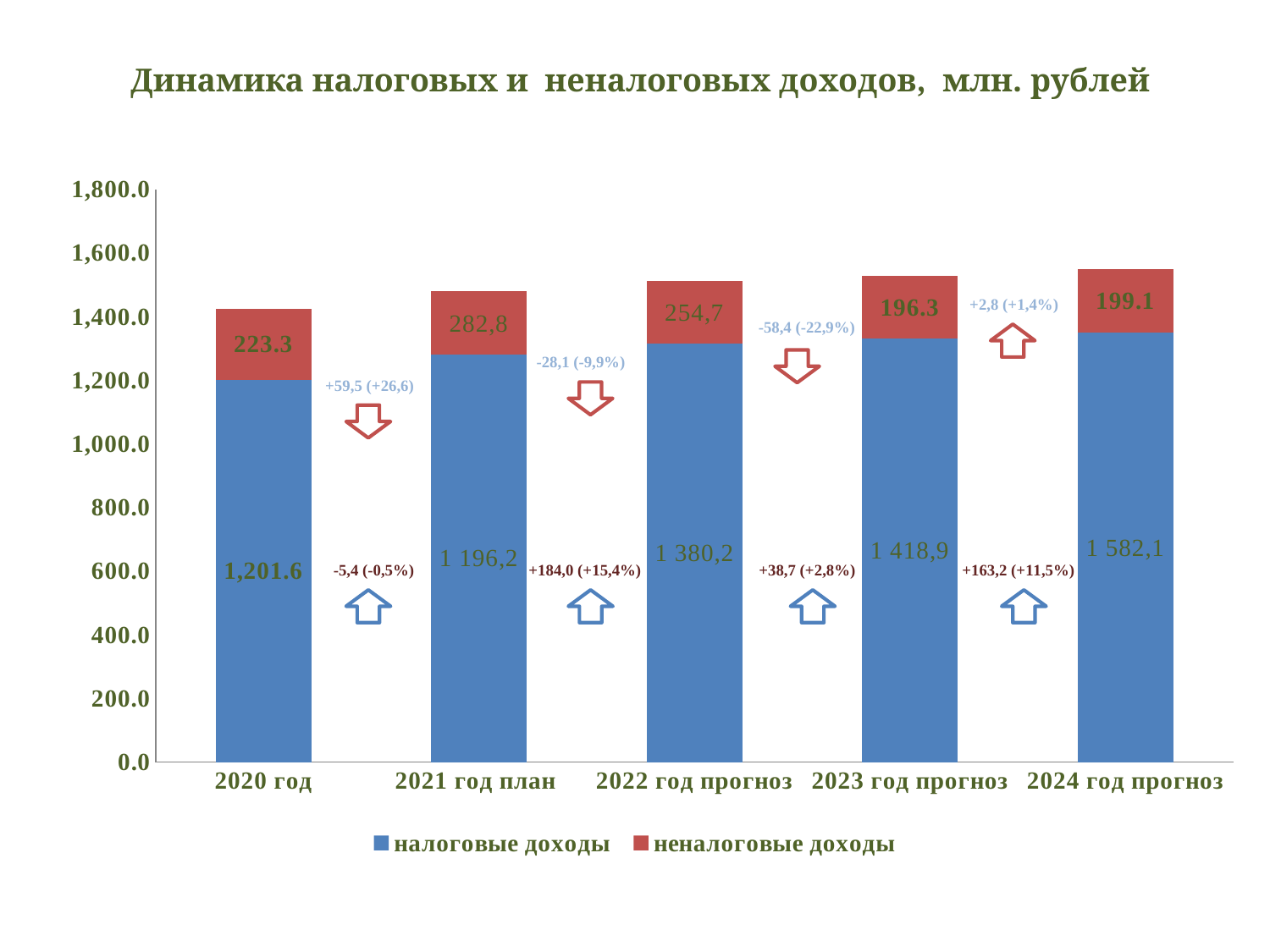
What is the value of налоговые доходы for 2024 год прогноз? 1 582,1 What is the value of налоговые доходы for 2020 год? 1,201.6 How many series does the legend list? 2 What is the value of неналоговые доходы for 2023 год прогноз? 196.3 How many year categories are shown on the x axis? 5 What is the value of неналоговые доходы for 2021 год план? 282,8 By how much do неналоговые доходы in 2021 год план exceed those in 2020 год? 59,5 Which is larger: неналоговые доходы in 2022 год прогноз or in 2023 год прогноз? 2022 год прогноз Which year has the highest value of налоговые доходы? 2024 год прогноз What type of chart is shown on the slide? stacked bar chart Which colour represents неналоговые доходы in the chart? red